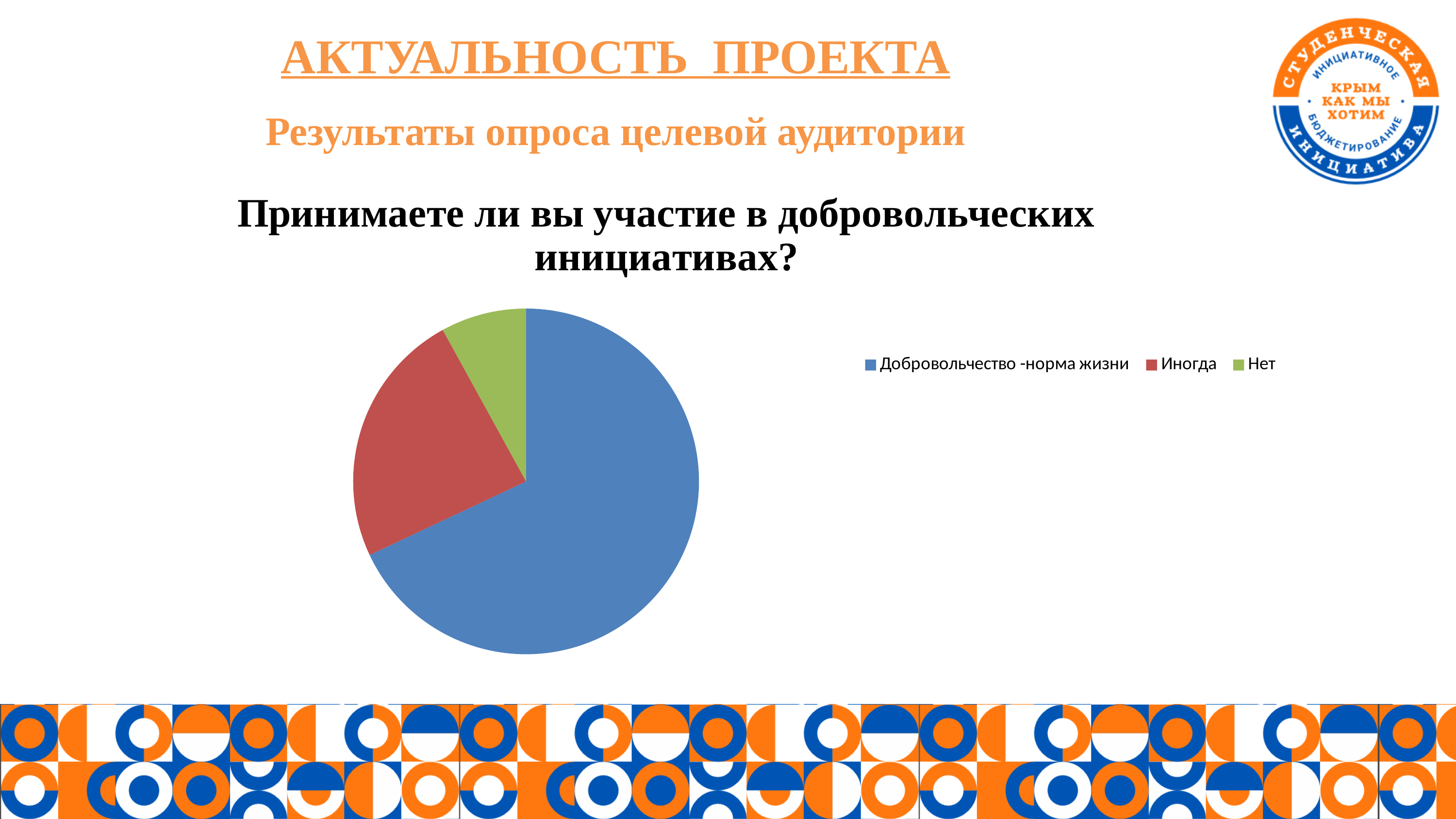
How many entries does the legend of the pie chart list? 3 Which category has the largest slice in the pie chart? Добровольчество -норма жизни How many slices does the pie chart have? 3 What colour represents the category Нет in the pie chart? Green Which category has the smallest slice in the pie chart? Нет What question is the pie chart titled with? Принимаете ли вы участие в добровольческих инициативах? Which slice is larger in the pie chart: Добровольчество -норма жизни or Иногда? Добровольчество -норма жизни What kind of chart is shown on the slide? Pie chart Which slice is larger in the pie chart: Иногда or Нет? Иногда